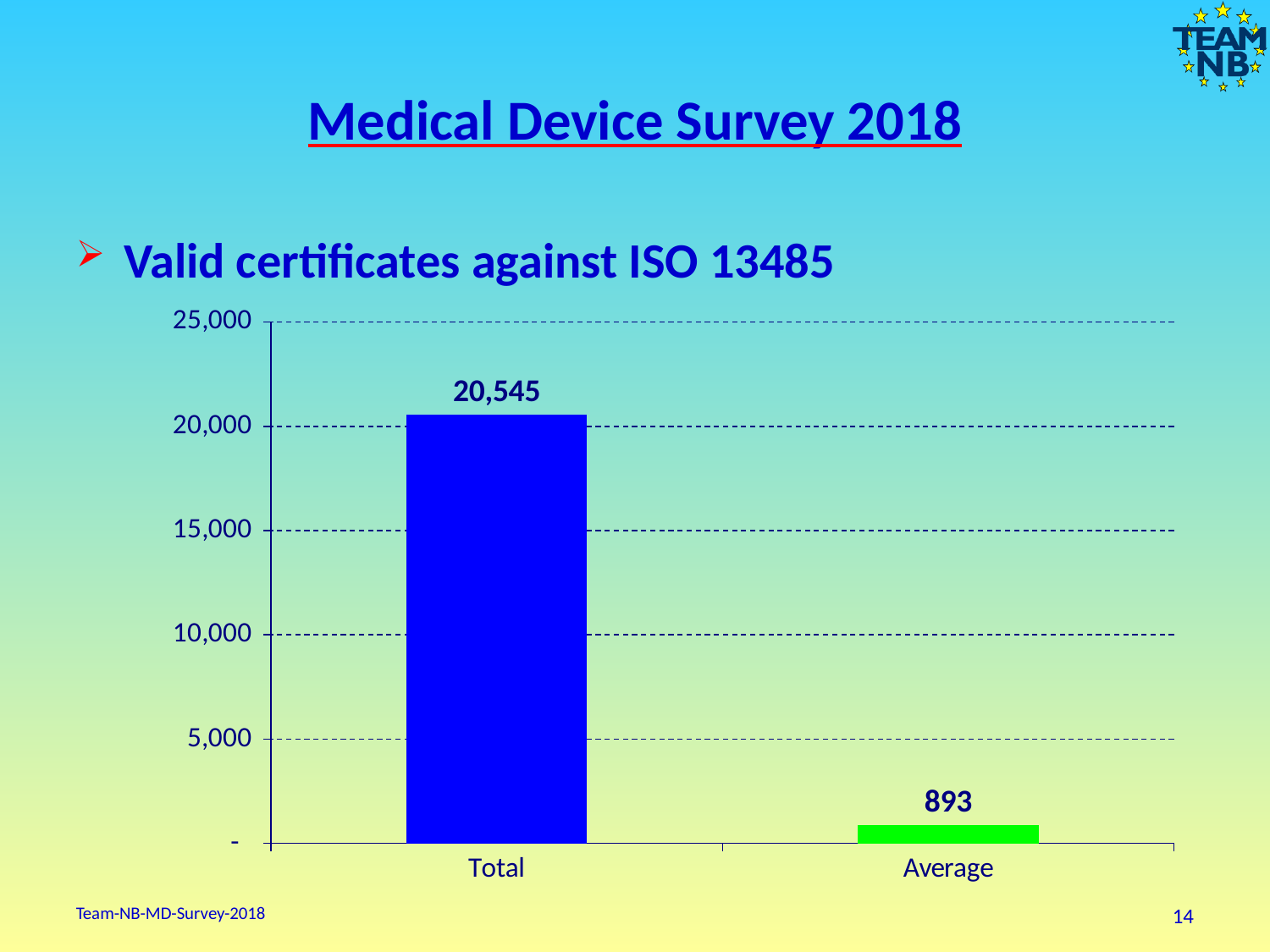
What kind of chart is shown on the slide? bar chart Which category has the lowest value? Average What is the value for Average in the chart? 893 What is the heading above the chart? Valid certificates against ISO 13485 What is the difference between the Total and Average values? 19,652 How many categories are shown on the x axis? 2 Which category has the highest value? Total Which is larger, the value for Total or the value for Average? Total Is the value for Total greater or less than 20,000? greater What is the value for Total in the chart? 20,545 What colour is the Average bar? green Is the value for Average greater or less than 5,000? less